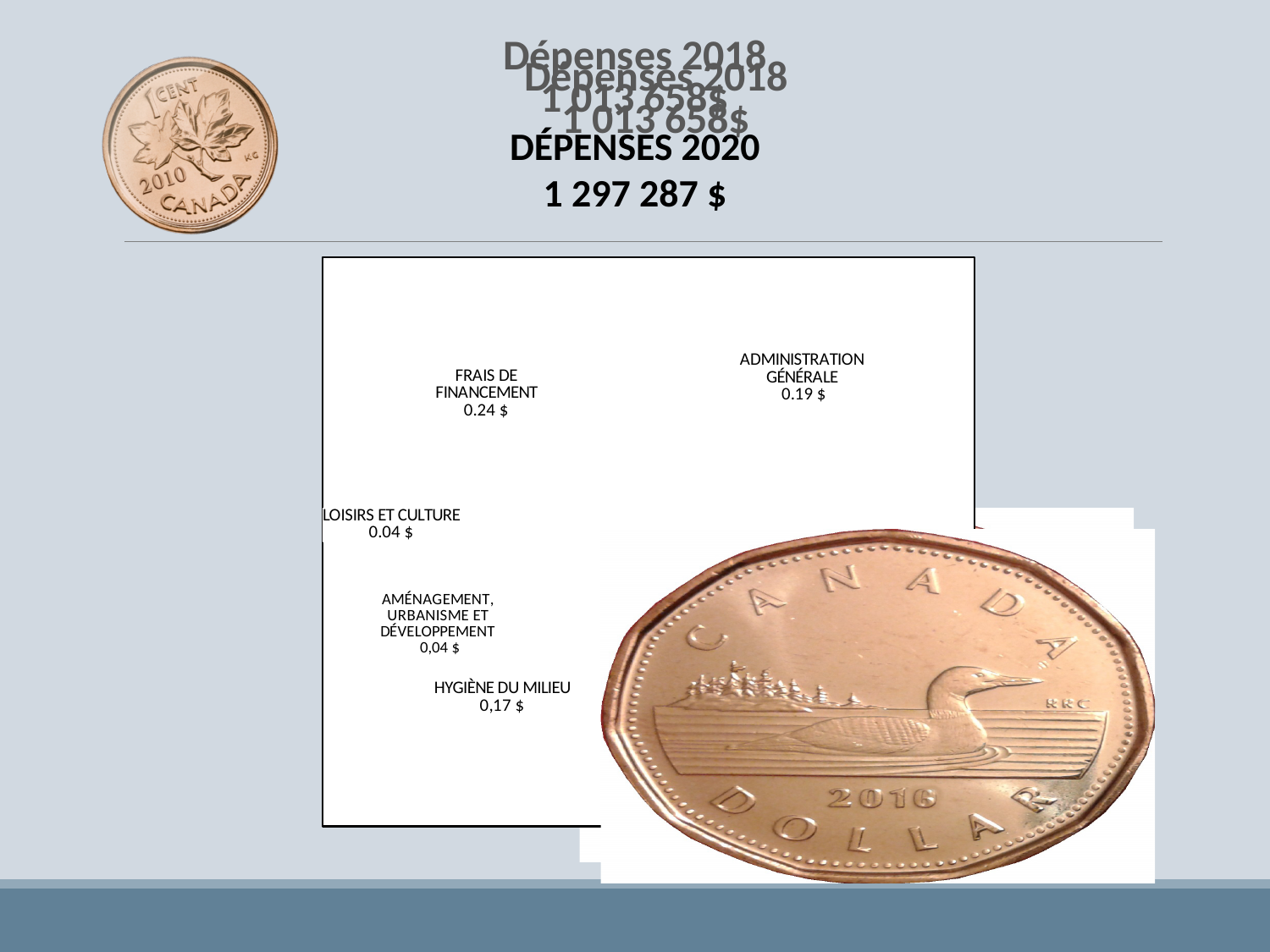
What is the value shown for FRAIS DE FINANCEMENT? 0.24 $ What is the difference between the values for ADMINISTRATION GÉNÉRALE and HYGIÈNE DU MILIEU? 0.02 $ What is the value shown for AMÉNAGEMENT, URBANISME ET DÉVELOPPEMENT? 0,04 $ What is the value shown for ADMINISTRATION GÉNÉRALE? 0.19 $ What is the difference between the values for FRAIS DE FINANCEMENT and LOISIRS ET CULTURE? 0.20 $ What is the difference between the values for FRAIS DE FINANCEMENT and ADMINISTRATION GÉNÉRALE? 0.05 $ What total amount is shown under the heading DÉPENSES 2020? 1 297 287 $ What is the value shown for LOISIRS ET CULTURE? 0.04 $ What is the value shown for HYGIÈNE DU MILIEU? 0,17 $ Which is larger, the value for HYGIÈNE DU MILIEU or the value for LOISIRS ET CULTURE? HYGIÈNE DU MILIEU Which is larger, the value for FRAIS DE FINANCEMENT or the value for ADMINISTRATION GÉNÉRALE? FRAIS DE FINANCEMENT